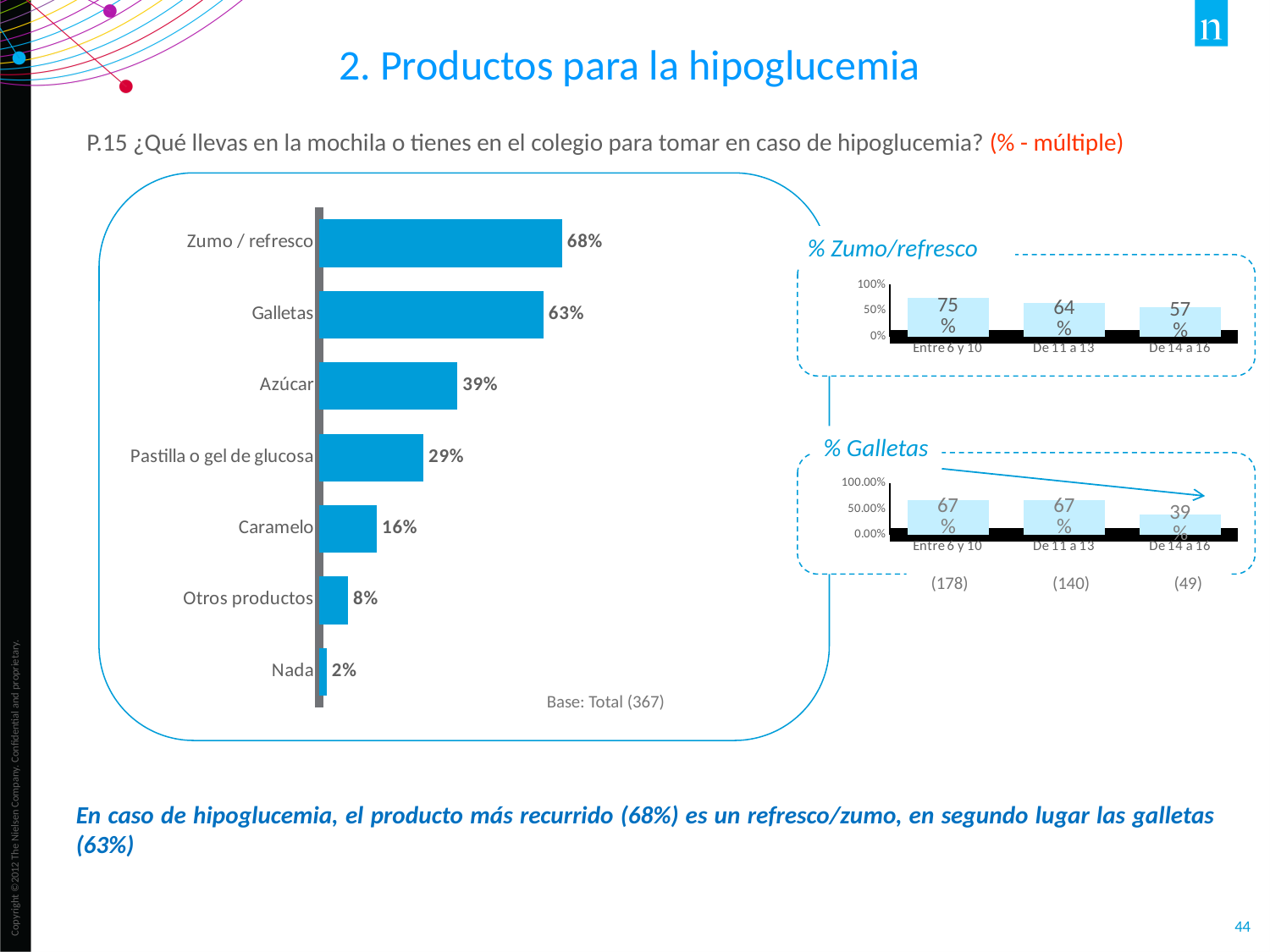
In the main bar chart on the left, what is the difference between Zumo / refresco and Azúcar? 29% In the % Zumo/refresco chart, what is the value for De 14 a 16? 57% What kind of chart is the main chart on the left? Bar chart In the main bar chart on the left, what is the value for Pastilla o gel de glucosa? 29% In the % Zumo/refresco chart, do the values rise or fall from Entre 6 y 10 to De 14 a 16? Fall In the main bar chart on the left, what is the value for Galletas? 63% In the main bar chart on the left, which category has the lowest value? Nada How many categories does the main bar chart on the left show? 7 In the % Galletas chart, what is the value for Entre 6 y 10? 67% In the main bar chart on the left, which category has the highest value? Zumo / refresco In the main bar chart on the left, which is larger, Caramelo or Otros productos? Caramelo In the % Galletas chart, what is the difference between De 11 a 13 and De 14 a 16? 28%